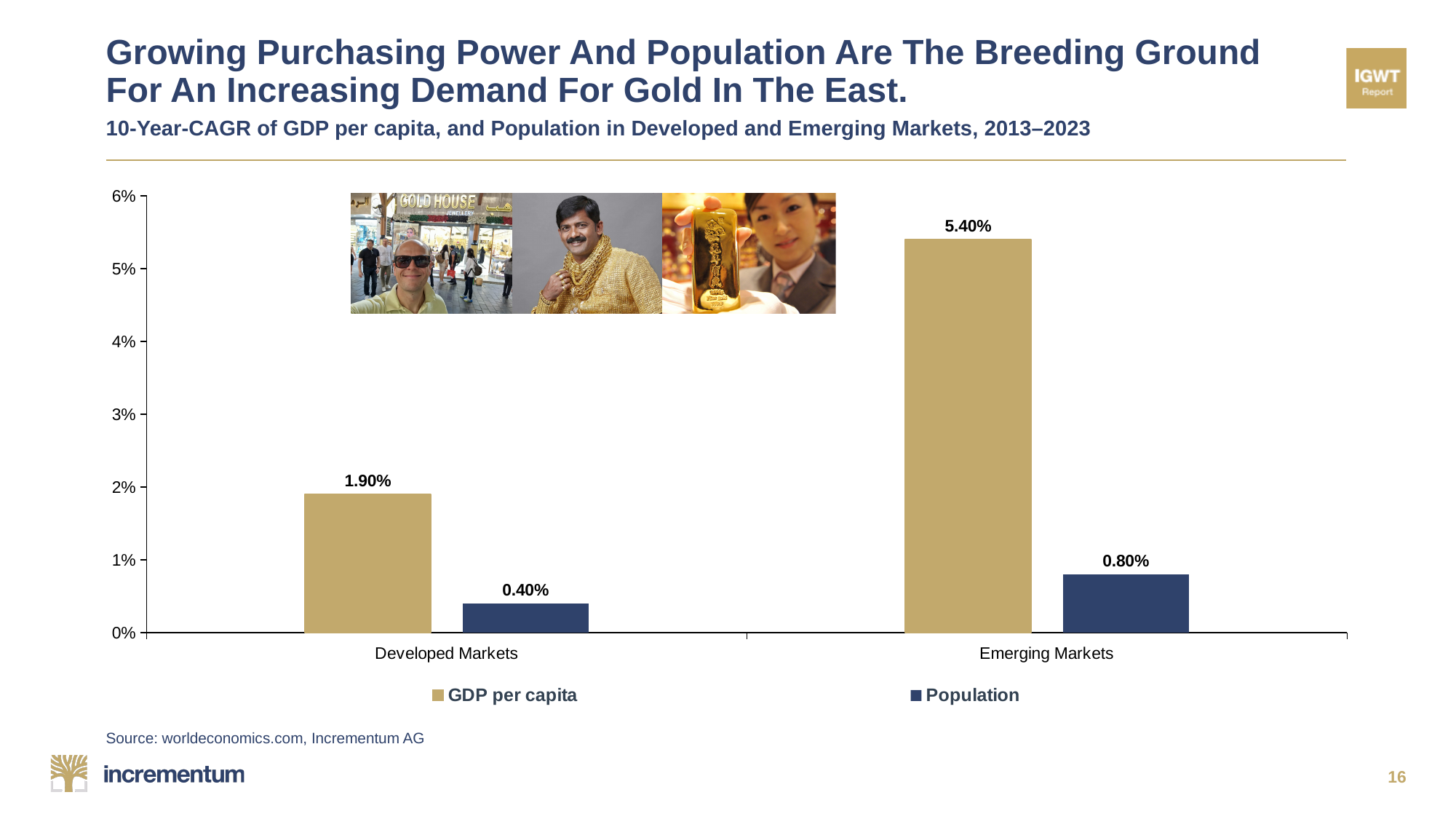
What kind of chart is shown on the slide? Bar chart How many market categories are shown on the x axis? 2 What is the difference between the Population CAGR of Emerging Markets and Developed Markets? 0.40% What is the 10-year CAGR of GDP per capita for Emerging Markets? 5.40% Which bar in the chart has the lowest value? Population, Developed Markets What is the 10-year CAGR of Population for Emerging Markets? 0.80% What is the difference between the GDP per capita CAGR of Emerging Markets and Developed Markets? 3.50% What is the 10-year CAGR of Population for Developed Markets? 0.40% What is the 10-year CAGR of GDP per capita for Developed Markets? 1.90% How many series does the legend list? 2 Which is larger: the Population CAGR for Emerging Markets or for Developed Markets? Emerging Markets Which bar in the chart has the highest value? GDP per capita, Emerging Markets